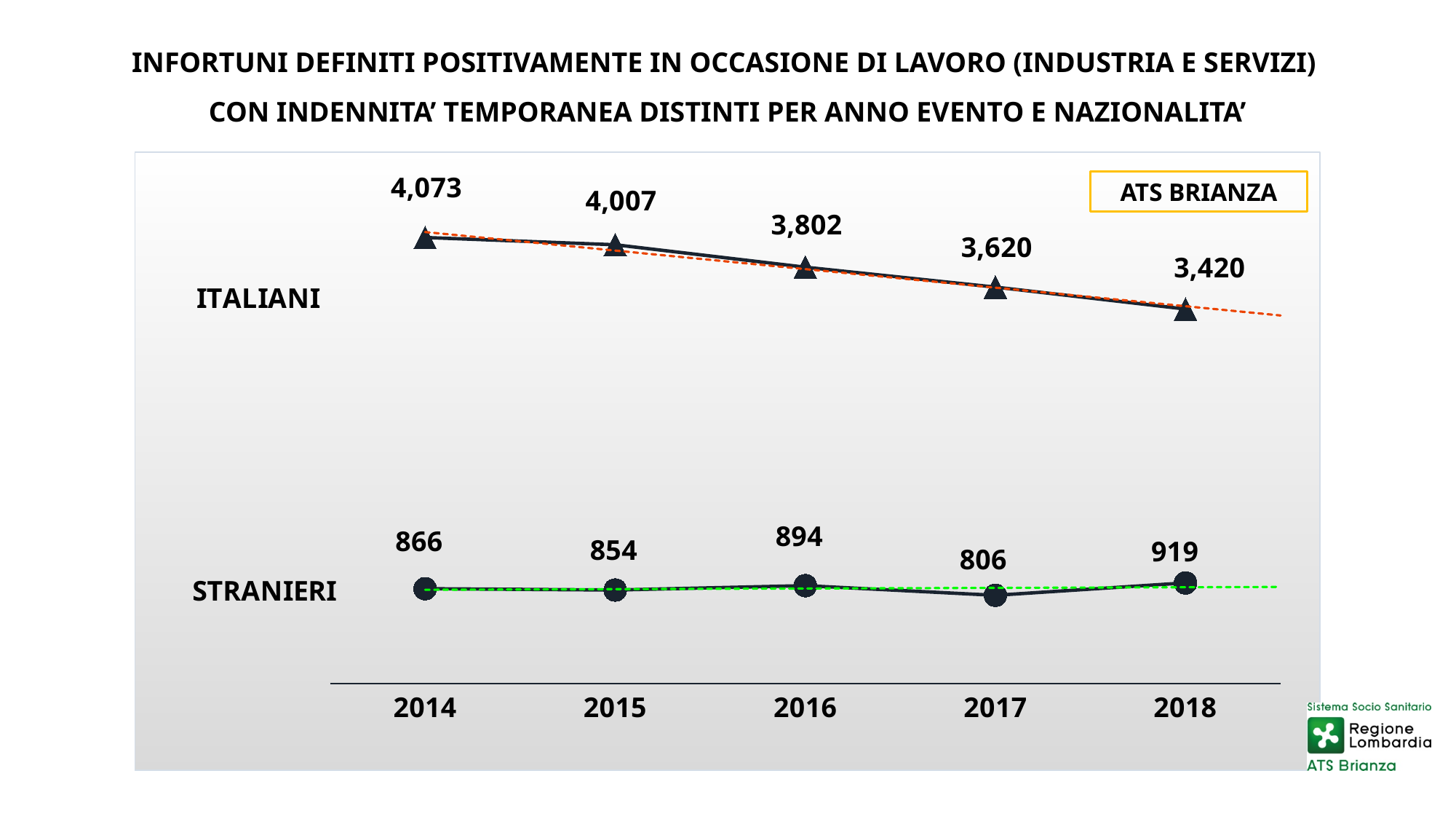
How many years are shown on the x axis? 5 What is the value for ITALIANI in 2014? 4,073 What is the value for ITALIANI in 2018? 3,420 What text appears in the yellow-bordered box at the top right of the chart? ATS BRIANZA What is the value for STRANIERI in 2017? 806 How many data series are plotted on the chart? 2 What is the difference between the ITALIANI values in 2014 and 2018? 653 In which year is the STRANIERI value highest? 2018 Do the ITALIANI values rise or fall from 2014 to 2018? fall Which is larger, the STRANIERI value in 2016 or in 2015? 2016 In which year is the ITALIANI value lowest? 2018 What kind of chart is shown on the slide? line chart